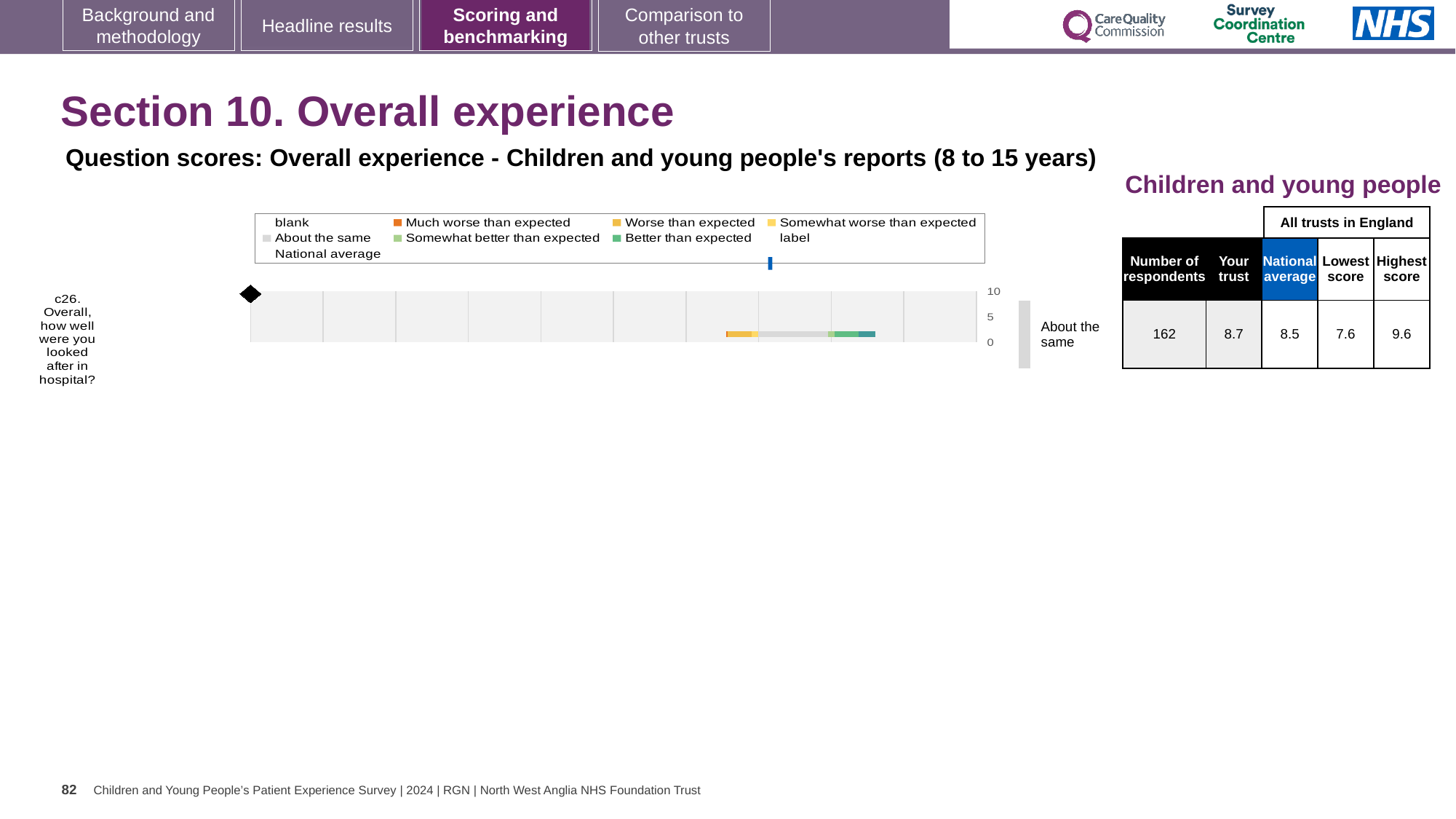
How many questions are plotted on the chart? 1 Is the trust's score for question c26 greater or less than 5 on the chart's axis? greater What benchmark category is shown next to the bar for question c26? About the same What is the 'Your trust' score for question c26 (Overall, how well were you looked after in hospital?)? 8.7 What is the highest score among all trusts in England for question c26? 9.6 By how much does the trust's score for c26 exceed the national average? 0.2 How many respondents answered question c26? 162 Which is higher for question c26: the trust's score or the national average? Your trust What is the difference between the highest and lowest scores for question c26 across all trusts in England? 2.0 What kind of chart is used to show the question score for c26? Bar chart What is the national average score for question c26? 8.5 What is the lowest score among all trusts in England for question c26? 7.6